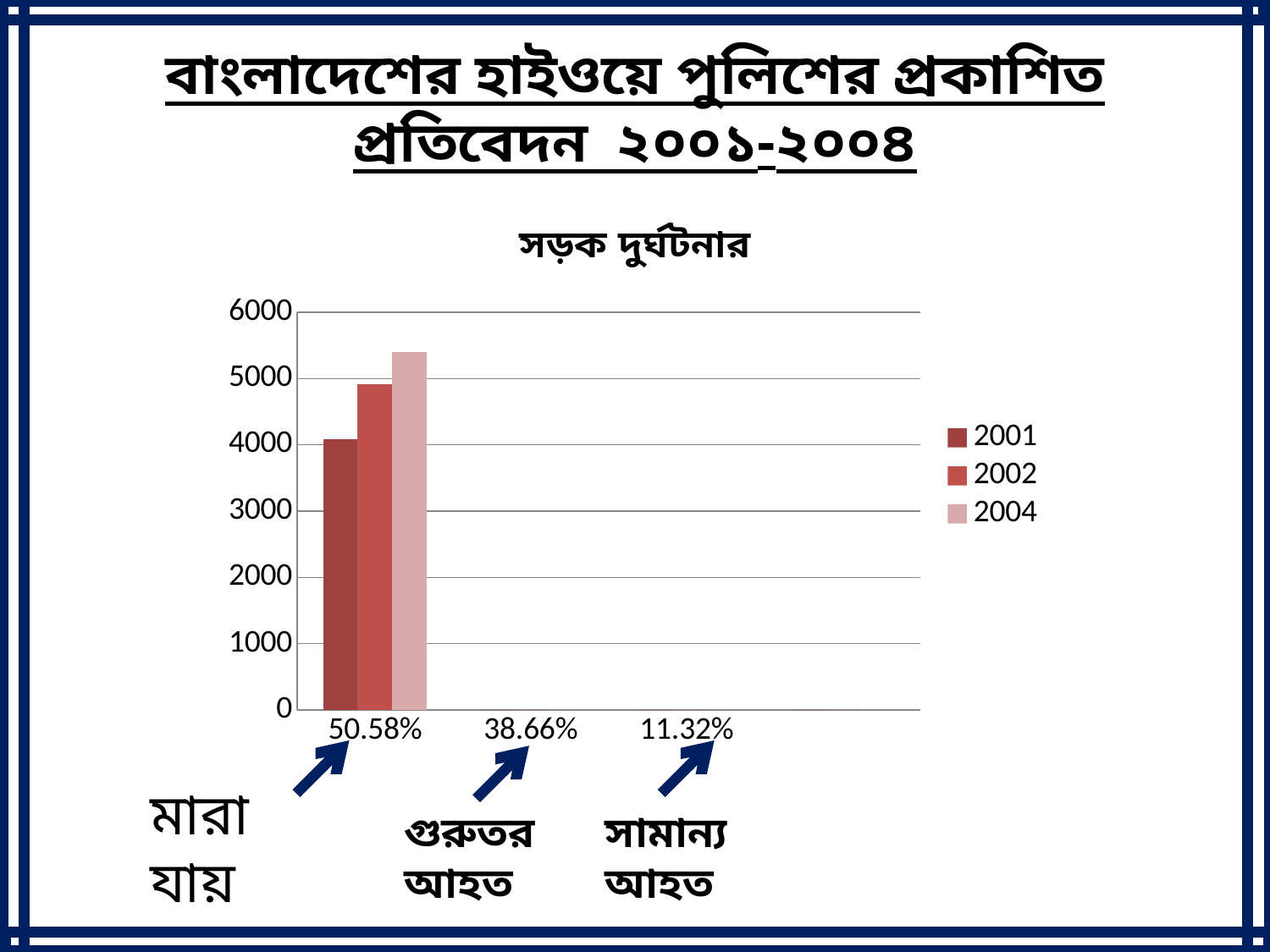
What is the title of the chart? সড়ক দুর্ঘটনার Is the value for 2004 in the 50.58% category greater or less than 5000? greater In the 50.58% category, which is larger, the 2002 bar or the 2001 bar? 2002 Which years are listed in the chart legend? 2001, 2002, 2004 In the 50.58% category, which series has the tallest bar? 2004 How many series does the chart legend list? 3 In the 50.58% category, which series has the shortest bar? 2001 Is the value for 2001 in the 50.58% category greater or less than 5000? less How many category labels are shown along the x axis of the chart? 3 Is the value for 2004 in the 50.58% category greater or less than 6000? less What kind of chart is shown on the slide? bar chart